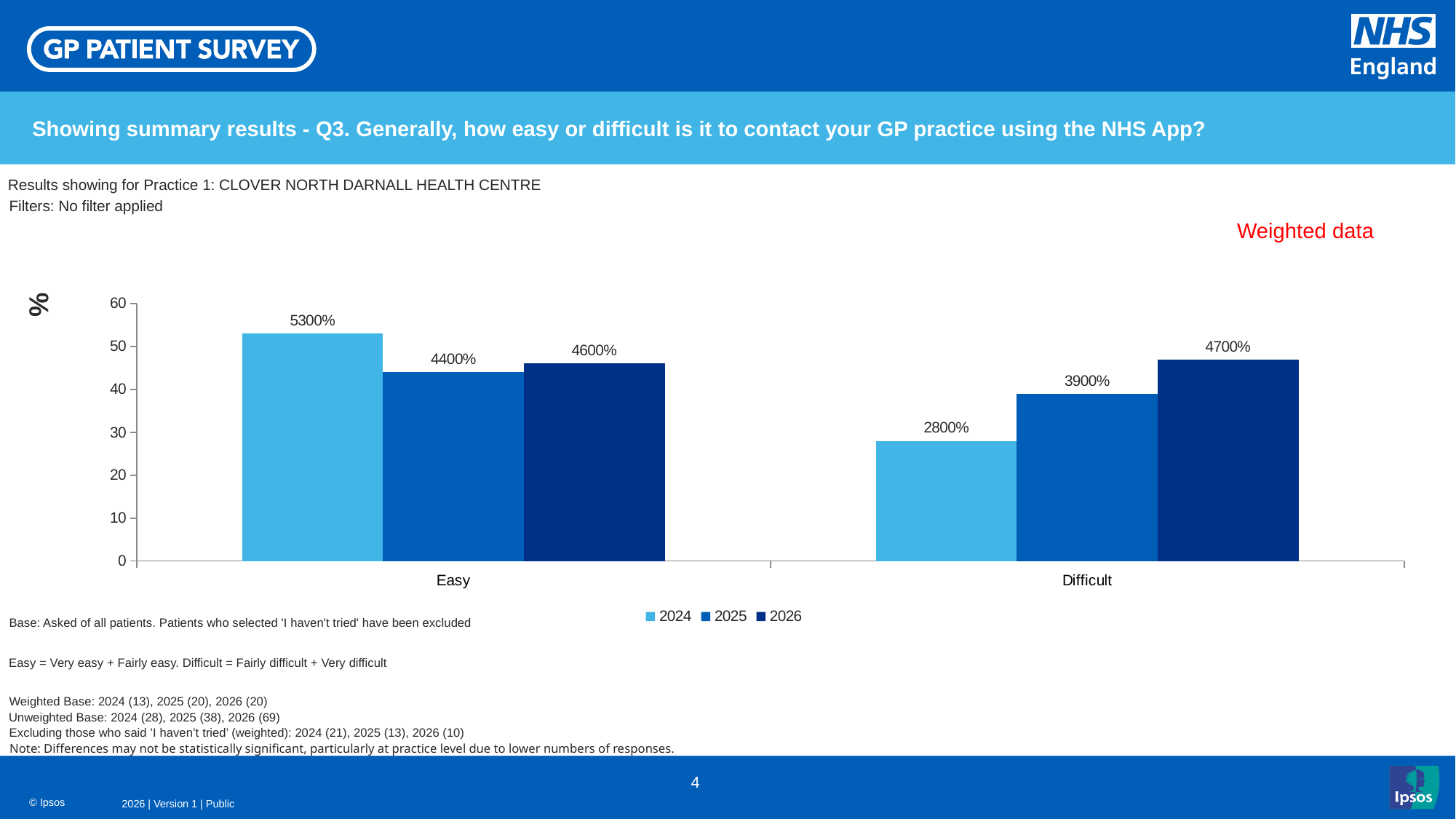
Which year has the highest bar in the Easy category? 2024 Is the 2024 bar in the Difficult category greater or less than 30 on the axis? less What is the data label for 2025 in the Difficult category? 3900% What is the data label for 2026 in the Easy category? 4600% Do the bars in the Difficult category rise or fall from 2024 to 2026? Rise Which is larger in the Difficult category: the 2025 bar or the 2026 bar? 2026 How many series does the legend list? 3 What is the data label for 2024 in the Easy category? 5300% What kind of chart is shown on the slide? Bar chart Which year has the lowest bar in the Difficult category? 2024 How many categories are shown on the x axis? 2 What is the data label for 2024 in the Difficult category? 2800%